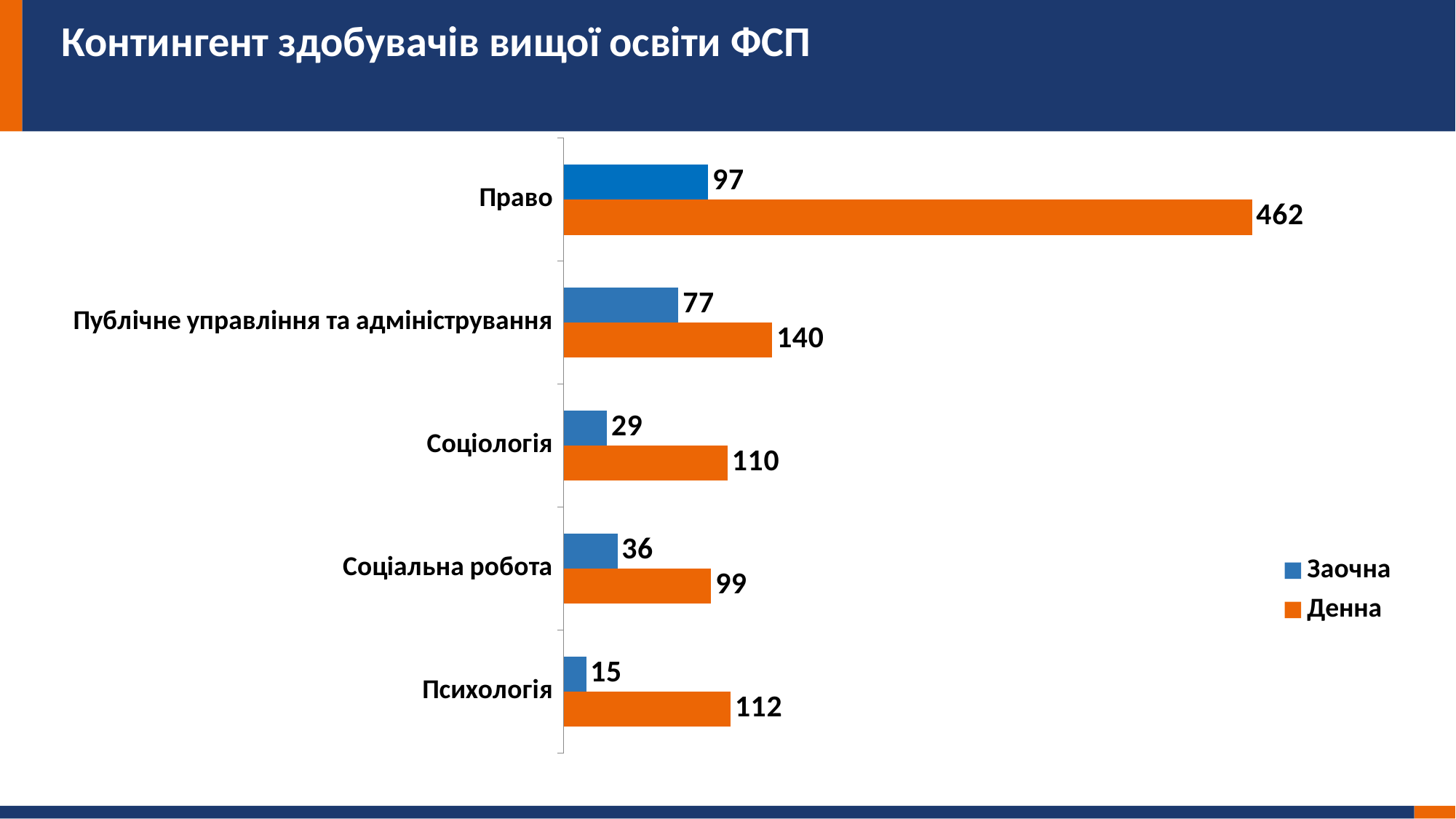
What is the Денна value for Психологія? 112 Which category has the highest Денна value? Право Which series is shown in orange? Денна Which category has the lowest Заочна value? Психологія How many series does the legend list? 2 What is the difference between the Денна and Заочна values for Публічне управління та адміністрування? 63 What is the Денна value for Право? 462 Which is larger: the Денна value for Соціологія or the Денна value for Соціальна робота? Соціологія What kind of chart is shown on the slide? Bar chart How many categories are shown on the chart? 5 What is the Заочна value for Соціологія? 29 What is the title of the slide? Контингент здобувачів вищої освіти ФСП